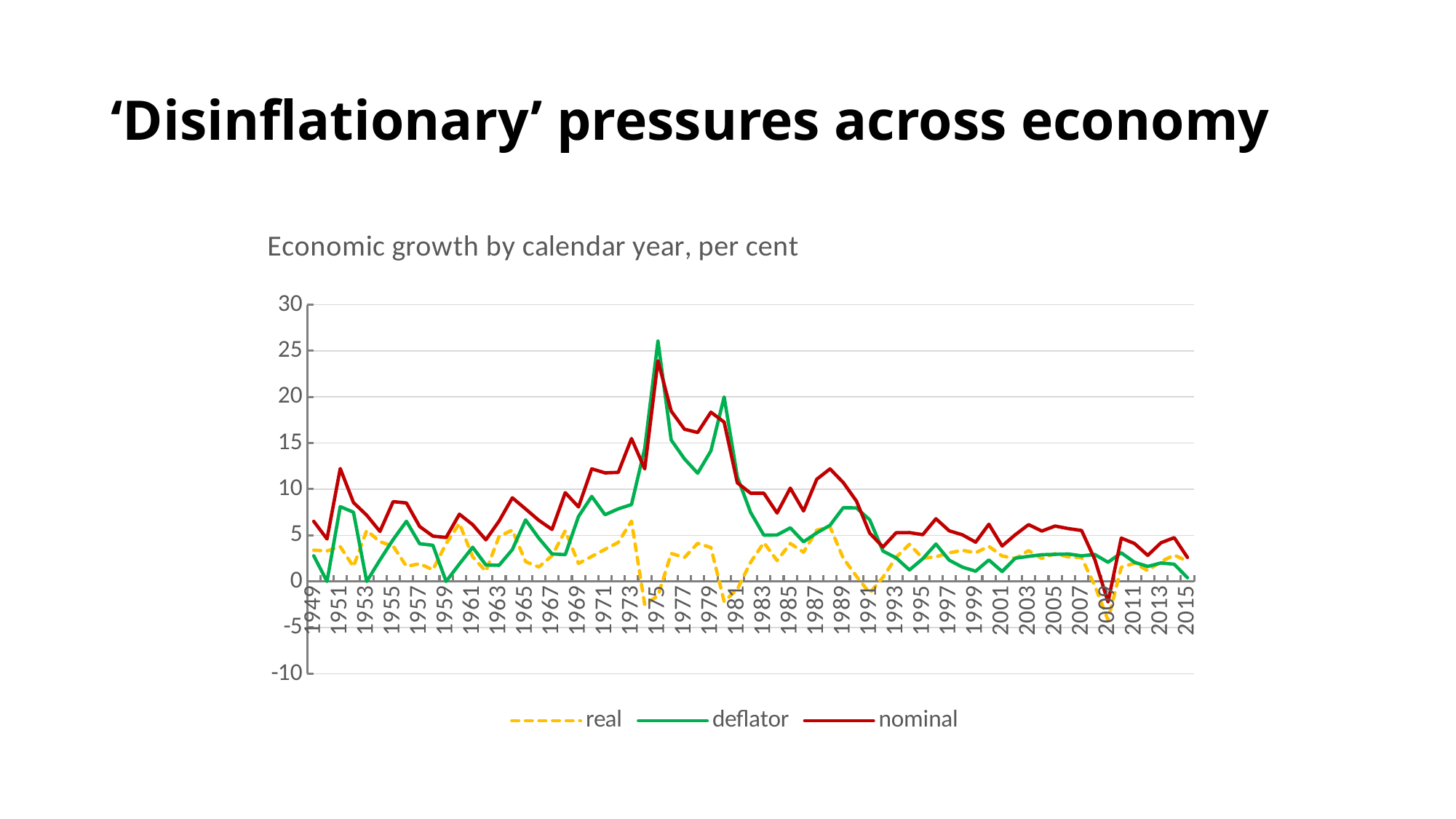
Is the value of the nominal series in 1951 greater or less than 10? greater What kind of chart is shown on the slide? line chart What are the three series named in the legend? real, deflator, nominal What is the chart's title (the text above the plot area)? Economic growth by calendar year, per cent Is the value of the nominal series in 1975 greater or less than 20? greater Does the nominal series generally rise or fall from 1975 to 2015? fall Is the value of the deflator series in 2015 greater or less than 5? less In 1951, which is larger: the nominal series or the deflator series? nominal In which year does the deflator series reach its highest value? 1975 How many series does the legend list? 3